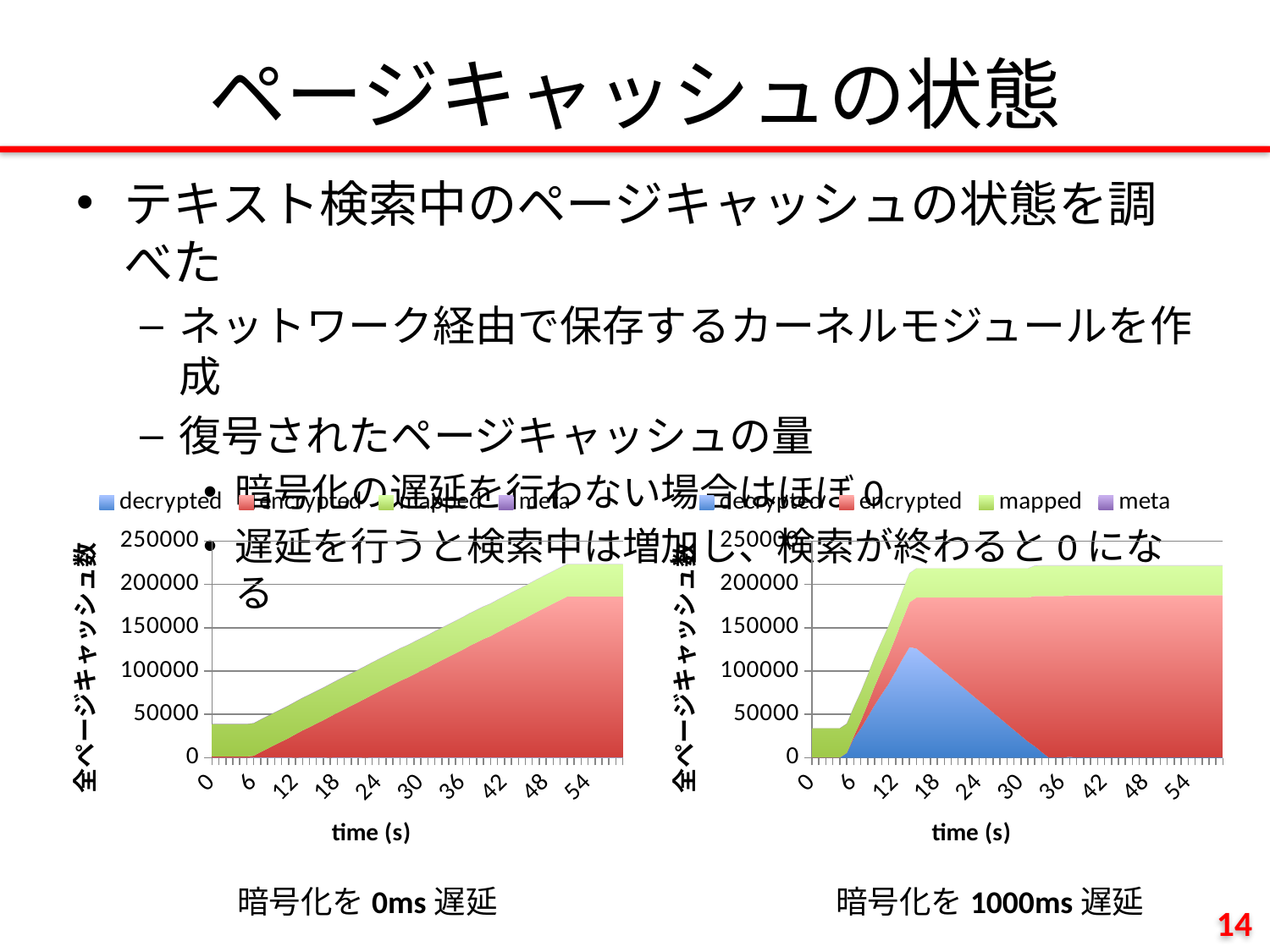
In the left chart (暗号化を 0ms 遅延), what is the label of the y axis? 全ページキャッシュ数 In the right chart (暗号化を 1000ms 遅延), is the peak value of the decrypted series greater or less than 100000? greater In the right chart (暗号化を 1000ms 遅延), which series is shown in blue? decrypted In the left chart (暗号化を 0ms 遅延), is the total page cache count at time 0 greater or less than 50000? less In the right chart (暗号化を 1000ms 遅延), what is the label of the x axis? time (s) In the right chart (暗号化を 1000ms 遅延), does the decrypted series rise or fall between time 18 and time 36? fall What kind of chart is the left chart (暗号化を 0ms 遅延)? area chart How many labeled tick marks are on the x axis of the left chart (暗号化を 0ms 遅延)? 10 In the left chart (暗号化を 0ms 遅延), is the total page cache count at time 54 greater or less than 200000? greater How many series does the legend of the right chart (暗号化を 1000ms 遅延) list? 4 In the left chart (暗号化を 0ms 遅延), does the encrypted series rise or fall as time increases from 6 to 54? rise